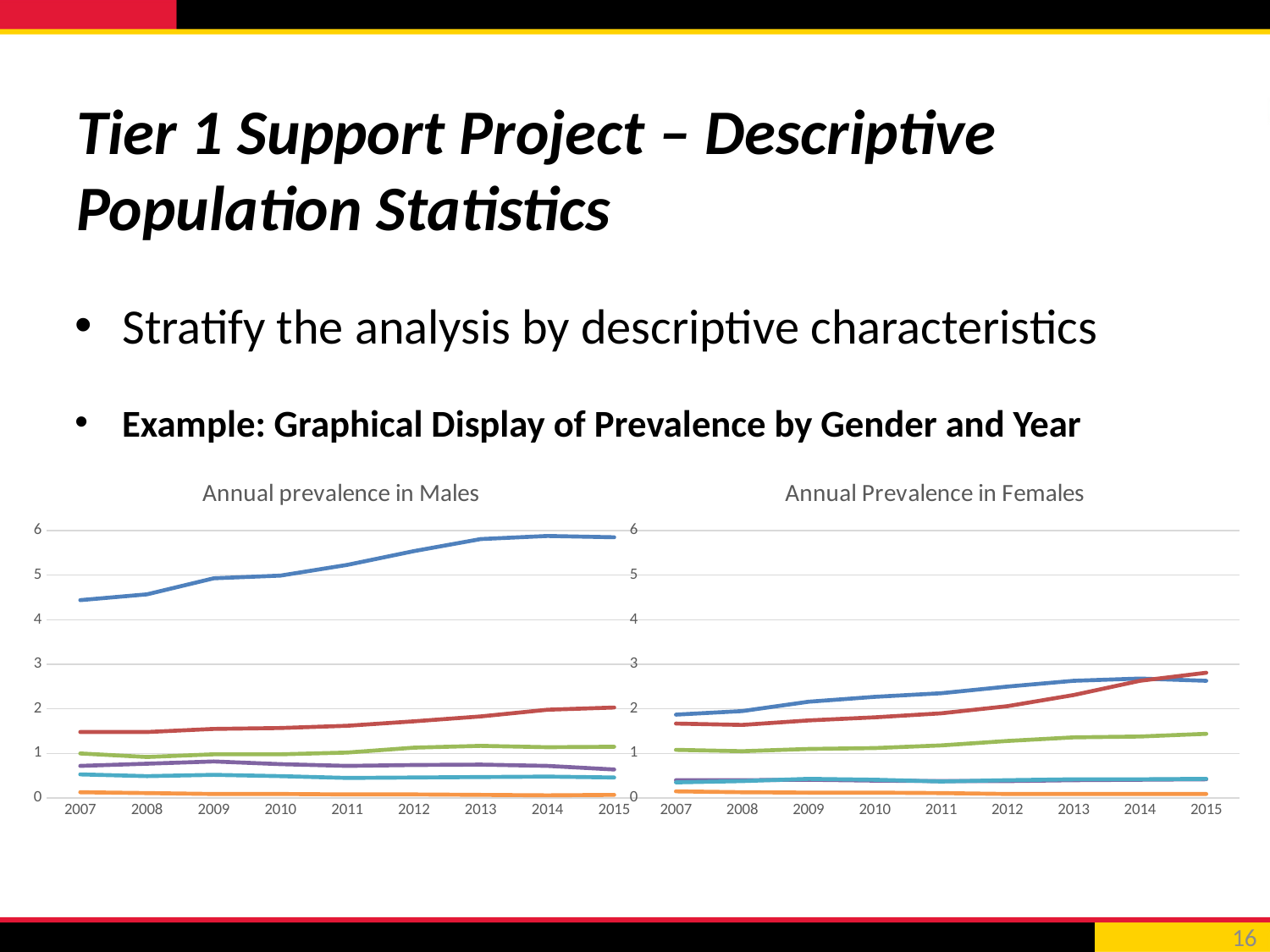
What is the title of the chart on the left of the slide? Annual prevalence in Males What is the title of the chart on the right of the slide? Annual Prevalence in Females What is the highest value shown on the y axis of the "Annual Prevalence in Females" chart? 6 What kind of chart is the "Annual prevalence in Males" chart? Line chart Which chart has the higher value for its top (blue) line in 2015, "Annual prevalence in Males" or "Annual Prevalence in Females"? Annual prevalence in Males How many years are shown on the x axis of the "Annual Prevalence in Females" chart? 9 In the "Annual prevalence in Males" chart, is the value of the top (blue) line in 2015 greater or less than 5? greater In the "Annual prevalence in Males" chart, is the value of the red line in 2007 greater or less than 2? less What is the first year shown on the x axis of the "Annual prevalence in Males" chart? 2007 In the "Annual prevalence in Males" chart, does the top (blue) line rise or fall from 2007 to 2015? Rise In the "Annual Prevalence in Females" chart, is the value of the red line in 2015 greater or less than 2? greater In the "Annual Prevalence in Females" chart, does the red line rise or fall from 2007 to 2015? Rise